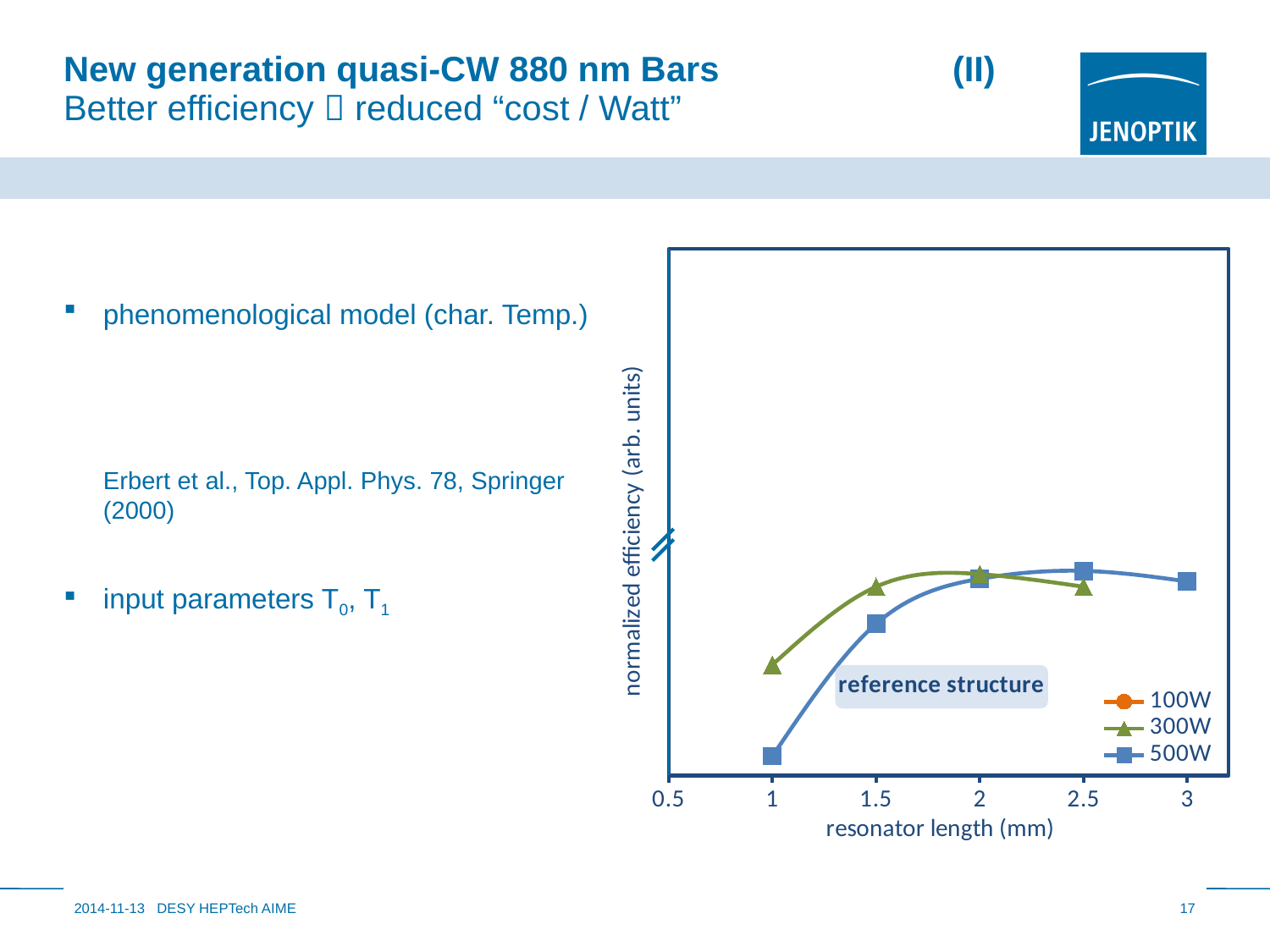
What are the series names listed in the legend? 100W, 300W, 500W How many series does the legend list? 3 Does the 300W series rise or fall between resonator lengths of 2 mm and 2.5 mm? fall What is the label of the x axis? resonator length (mm) How many data points are plotted for the 300W series? 4 At a resonator length of 1 mm, which series has the higher normalized efficiency, 300W or 500W? 300W Does the 500W series rise or fall between resonator lengths of 1 mm and 2 mm? rise What kind of chart is shown on the slide? line chart At which resonator length is the 300W series lowest? 1 How many data points are plotted for the 500W series? 5 At a resonator length of 1.5 mm, which series has the higher normalized efficiency, 300W or 500W? 300W At which resonator length is the 500W series lowest? 1